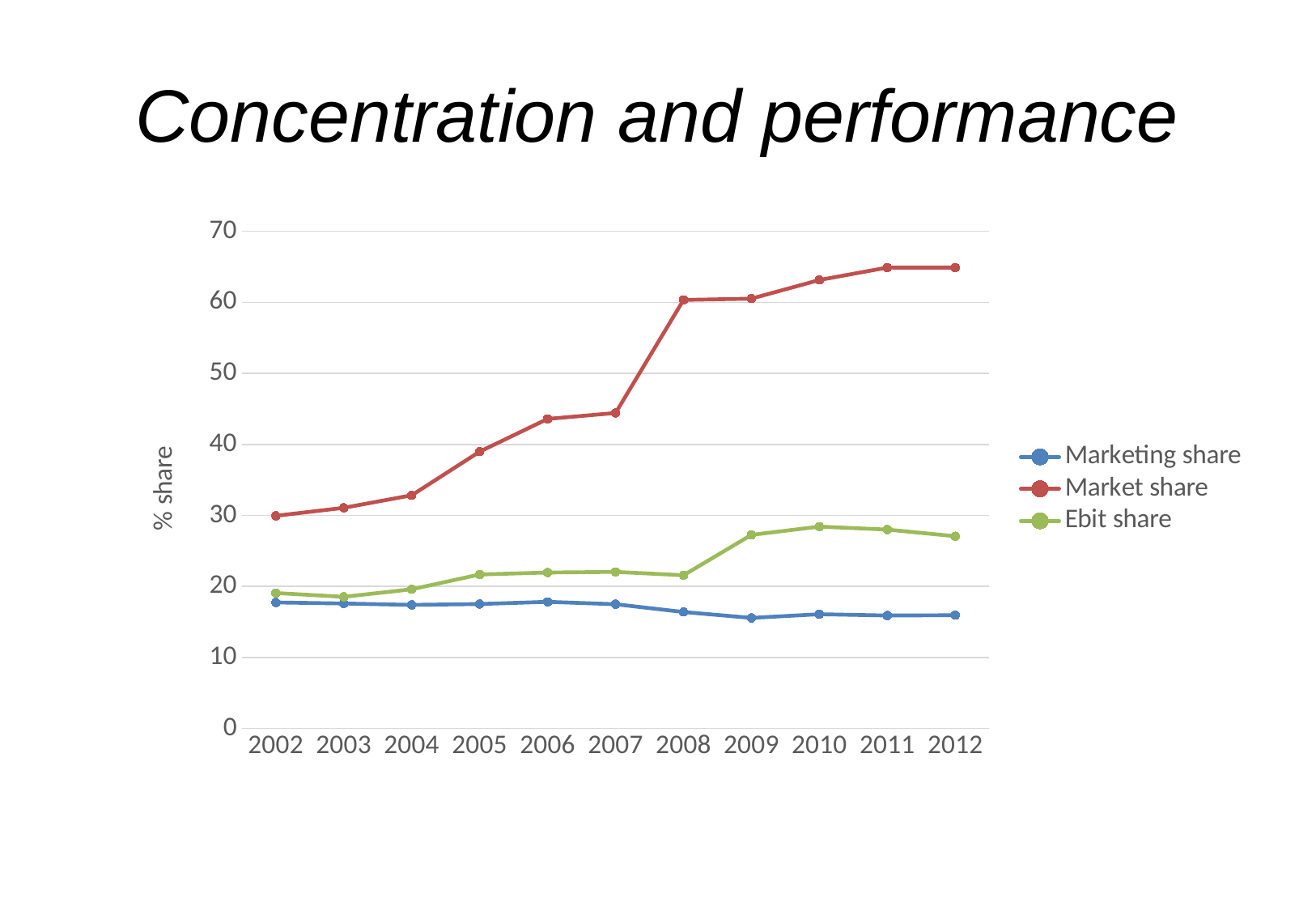
Is the value for Market share in 2002 greater or less than 40? less Is the value for Marketing share in 2009 greater or less than 20? less In which year is Market share lowest? 2002 How many series does the legend list? 3 Does the Market share series rise or fall from 2002 to 2012? rise Is the value for Market share in 2012 greater or less than 60? greater In 2012, which is larger: Ebit share or Marketing share? Ebit share What kind of chart is shown on the slide? line chart How many years are plotted along the x axis? 11 What is the label on the y axis? % share